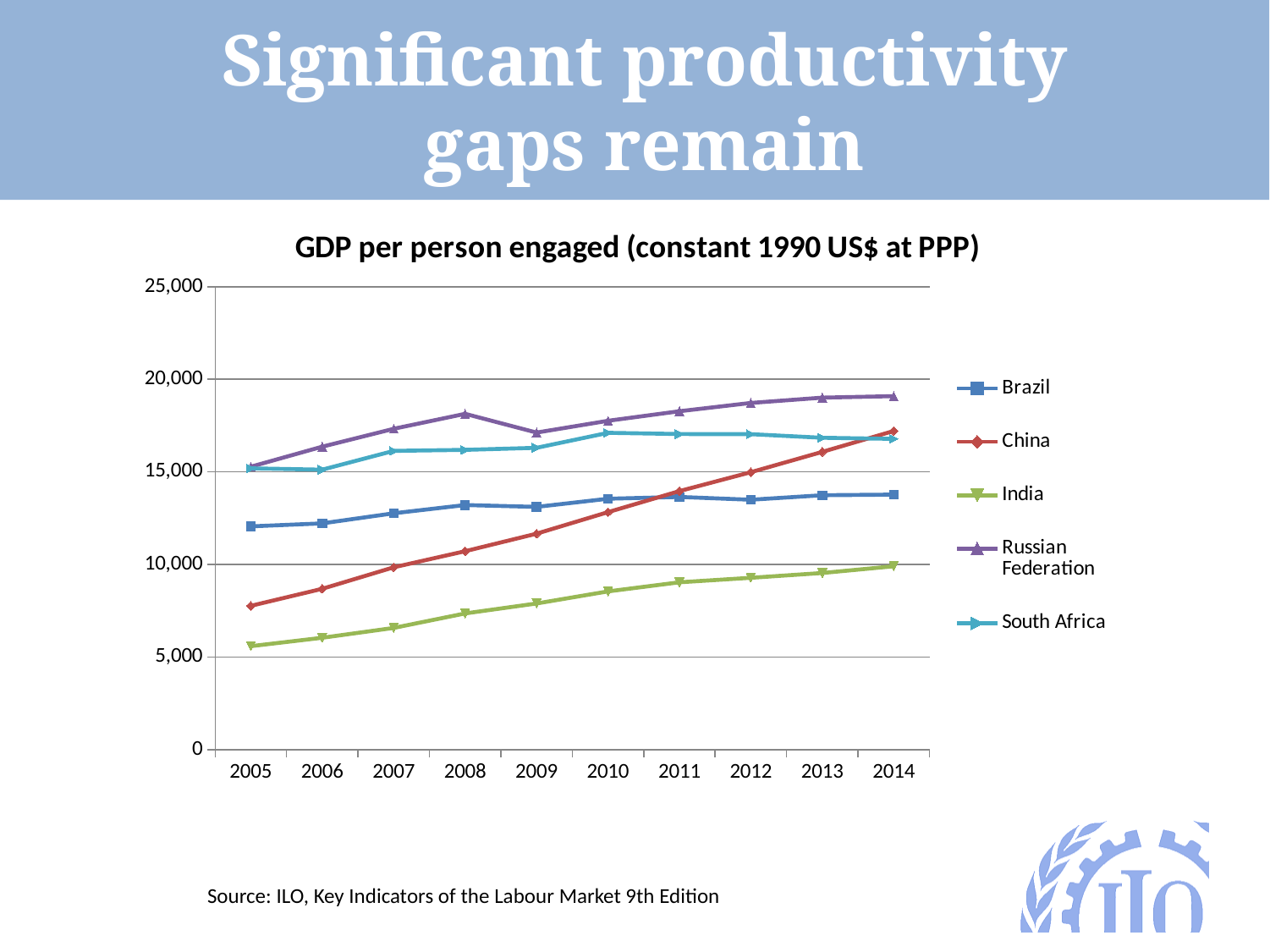
How many years are plotted along the x axis? 10 How many series does the legend list? 5 Does the value for China rise or fall from 2005 to 2014? rise In 2014, which is larger, the value for China or the value for Brazil? China Is the value for Brazil in 2014 greater or less than 15,000? less What kind of chart is shown on the slide? line chart What is the title of the chart? GDP per person engaged (constant 1990 US$ at PPP) Is the value for India in 2005 greater or less than 10,000? less Which country has the lowest GDP per person engaged in 2014? India Which country has the lowest GDP per person engaged in 2005? India Which country has the highest GDP per person engaged in 2014? Russian Federation Is the value for China in 2014 greater or less than 15,000? greater